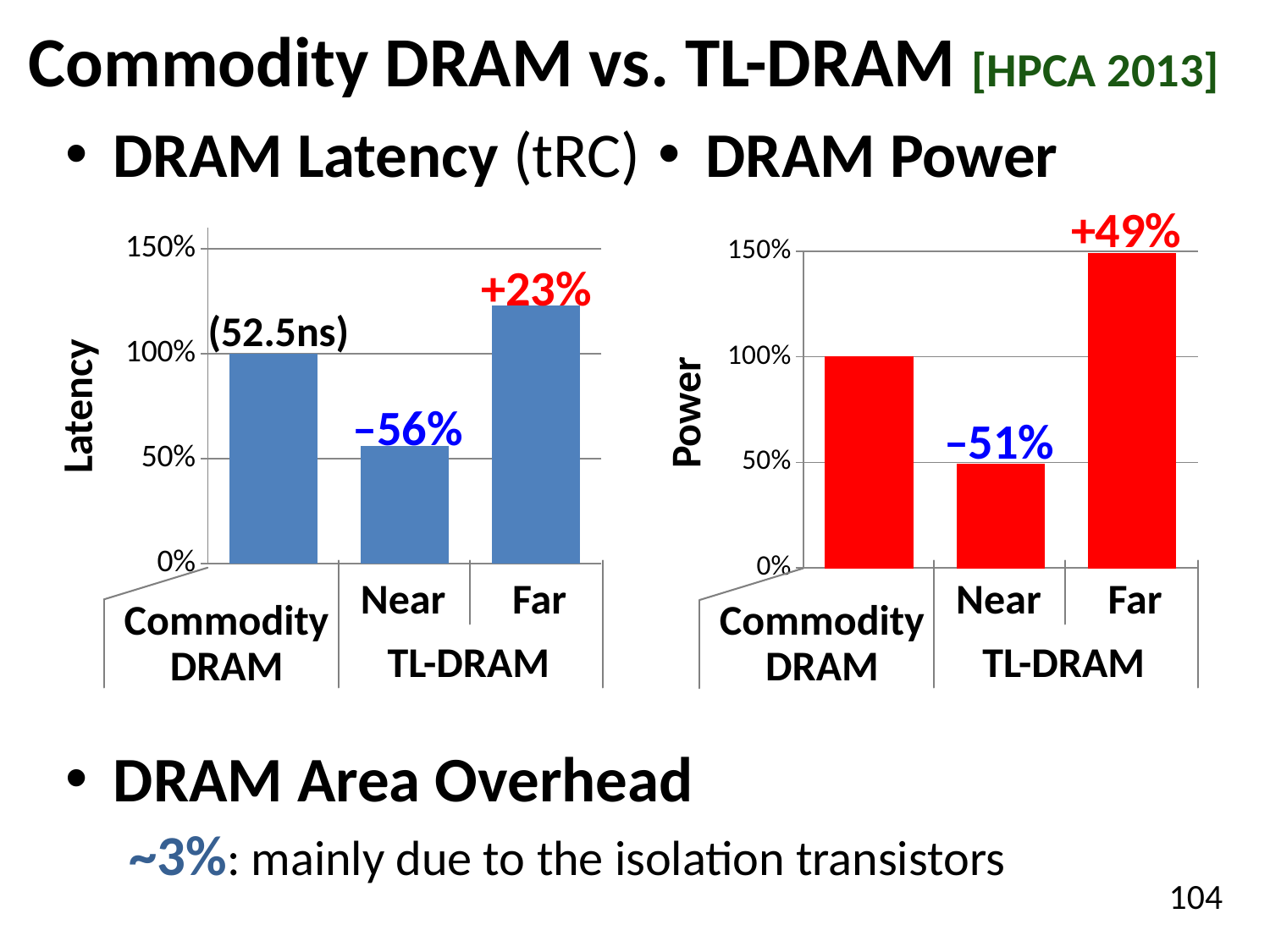
In the DRAM Power chart, which is larger, the Commodity DRAM bar or the Far TL-DRAM bar? Far TL-DRAM In the DRAM Latency chart, what absolute latency value is printed next to the Commodity DRAM bar? (52.5ns) How many bars are plotted in the DRAM Latency chart? 3 In the DRAM Latency chart, what label is printed above the Near bar for TL-DRAM? –56% In the DRAM Power chart, what label is printed above the Near bar for TL-DRAM? –51% In the DRAM Power chart, what label is printed above the Far bar for TL-DRAM? +49% In the DRAM Latency chart, which bar is the lowest? Near (TL-DRAM) What type of chart is the DRAM Power chart? Bar chart In the DRAM Power chart, which bar is the highest? Far (TL-DRAM) In the DRAM Latency chart, what label is printed above the Far bar for TL-DRAM? +23% In the DRAM Latency chart, is the value for the Far TL-DRAM bar greater or less than 100%? greater